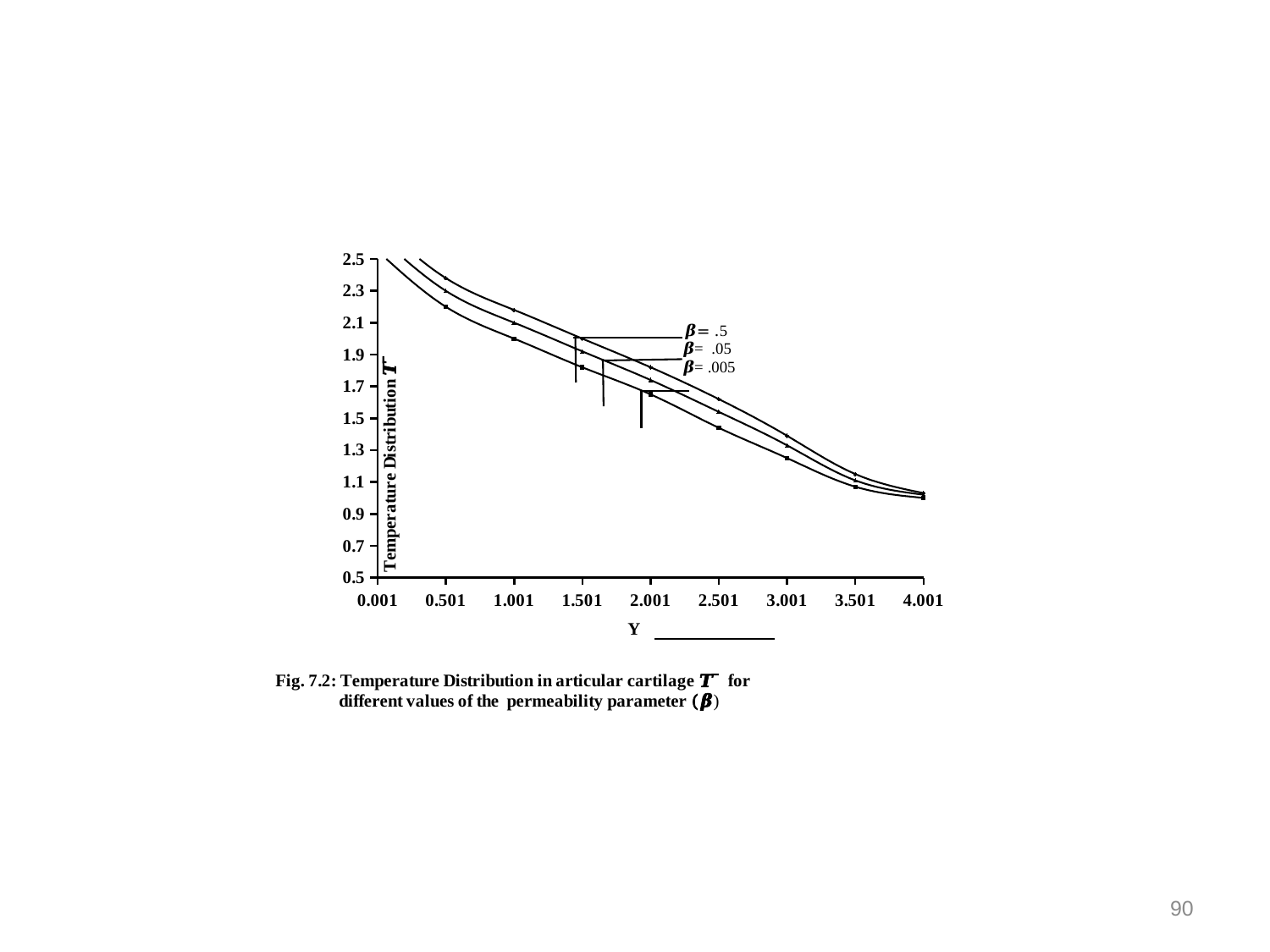
Is the value of the β = .5 curve at Y = 1.001 greater or less than 2.1? greater As Y increases from 0.001 to 4.001, do the temperature distribution curves rise or fall? fall Is the value of the β = .005 curve at Y = 2.501 greater or less than 1.5? less How many curves (values of β) are plotted on the chart? 3 What is the label of the y axis? Temperature Distribution T What kind of chart is shown on the slide? line chart Which value of β gives the highest temperature distribution curve across the chart? β = .5 At Y = 1.001, which curve is higher: β = .5 or β = .005? β = .5 Which value of β gives the lowest temperature distribution curve across the chart? β = .005 Is the value of the β = .5 curve at Y = 2.501 greater or less than 1.5? greater How many tick labels are shown on the x axis (Y)? 9